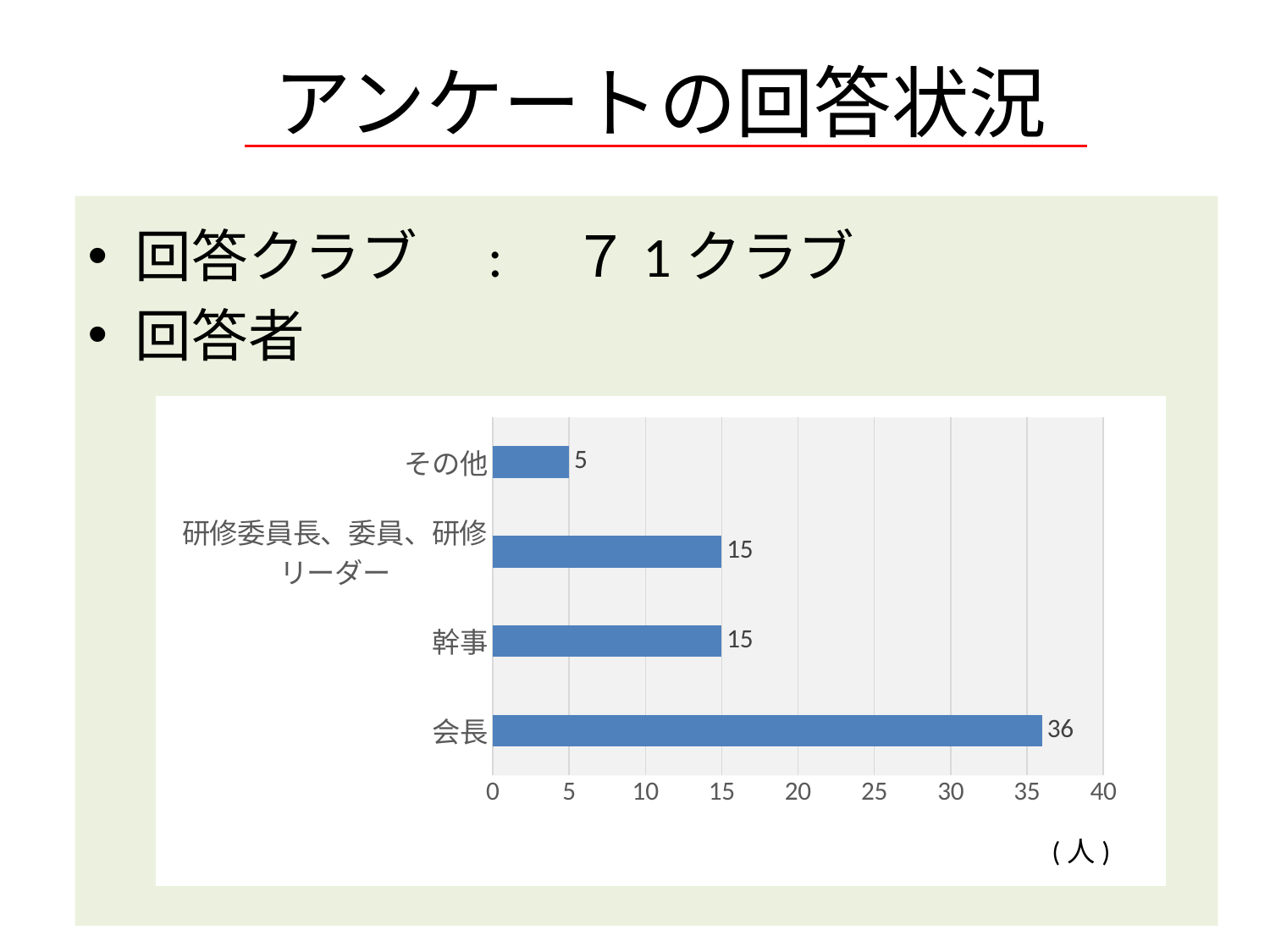
What unit is indicated below the chart's x axis? (人) What kind of chart is shown on the slide? bar chart How many categories are shown in the chart? 4 What is the value for その他? 5 Which is larger, the value for 会長 or the value for その他? 会長 Which category has the lowest value? その他 What is the difference between the values for 会長 and 幹事? 21 What is the value for 幹事? 15 What is the value for 研修委員長、委員、研修リーダー? 15 What is the value for 会長? 36 Which category has the highest value? 会長 What is the difference between the values for 幹事 and その他? 10